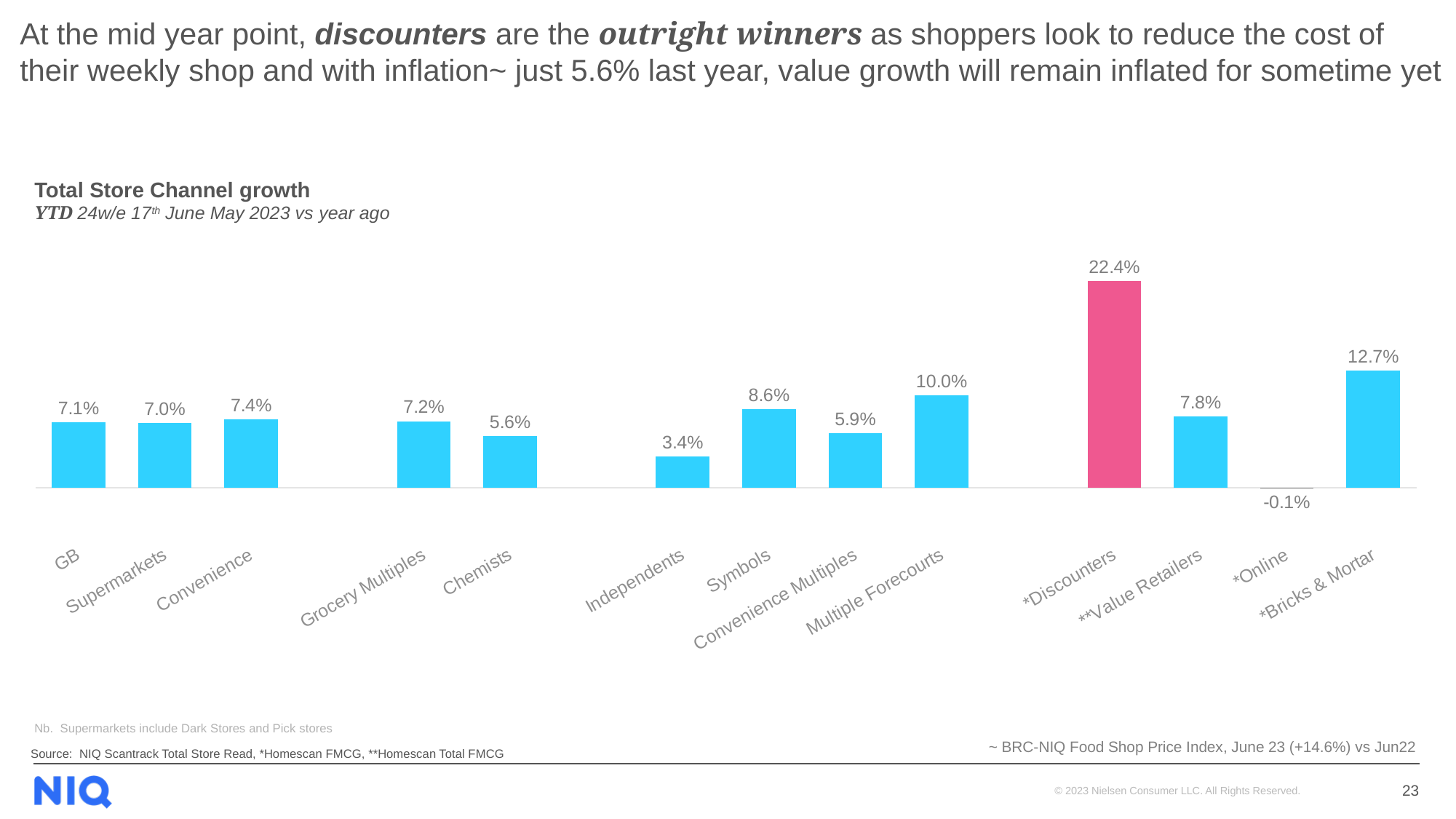
What is the value for *Online? -0.1% What is the difference between Symbols and Independents? 5.2% Which category has the lowest value? *Online Which bar is highlighted in a different colour (pink) from the others? *Discounters How many categories are shown on the chart? 14 What is the value for Independents? 3.4% Which category has the highest value? *Discounters What is the difference between *Discounters and *Bricks & Mortar? 9.7% What kind of chart is shown? Bar chart Which is larger, Chemists or Convenience Multiples? Convenience Multiples What is the value for *Discounters? 22.4% What is the value for Multiple Forecourts? 10.0%